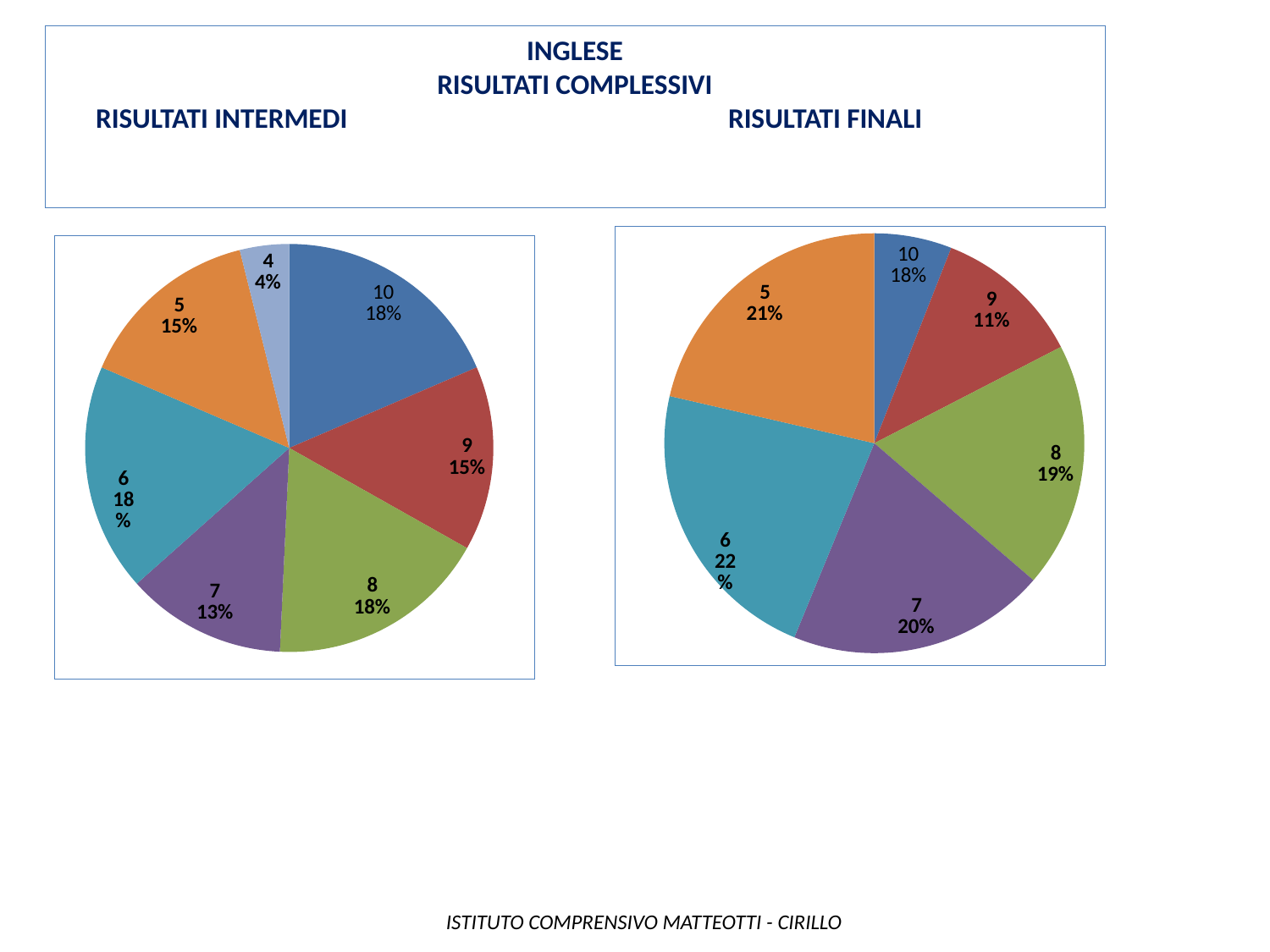
In the RISULTATI INTERMEDI pie chart, what share does the slice labelled 4 have? 4% How many slices does the RISULTATI INTERMEDI pie chart have? 7 In the RISULTATI FINALI pie chart, what is the difference in percentage points between the slice labelled 6 and the slice labelled 9? 11 In the RISULTATI FINALI pie chart, what percentage is shown for the slice labelled 6? 22% How many slices does the RISULTATI FINALI pie chart have? 6 In the RISULTATI INTERMEDI pie chart, which slice is the smallest? 4 What type of chart is used for RISULTATI INTERMEDI? Pie chart In the RISULTATI FINALI pie chart, which slice is the largest? 6 In the RISULTATI FINALI pie chart, which slice is larger, 5 or 8? 5 What is the subject named in the title above the two charts? INGLESE In the RISULTATI INTERMEDI pie chart, what percentage is shown for the slice labelled 7? 13%